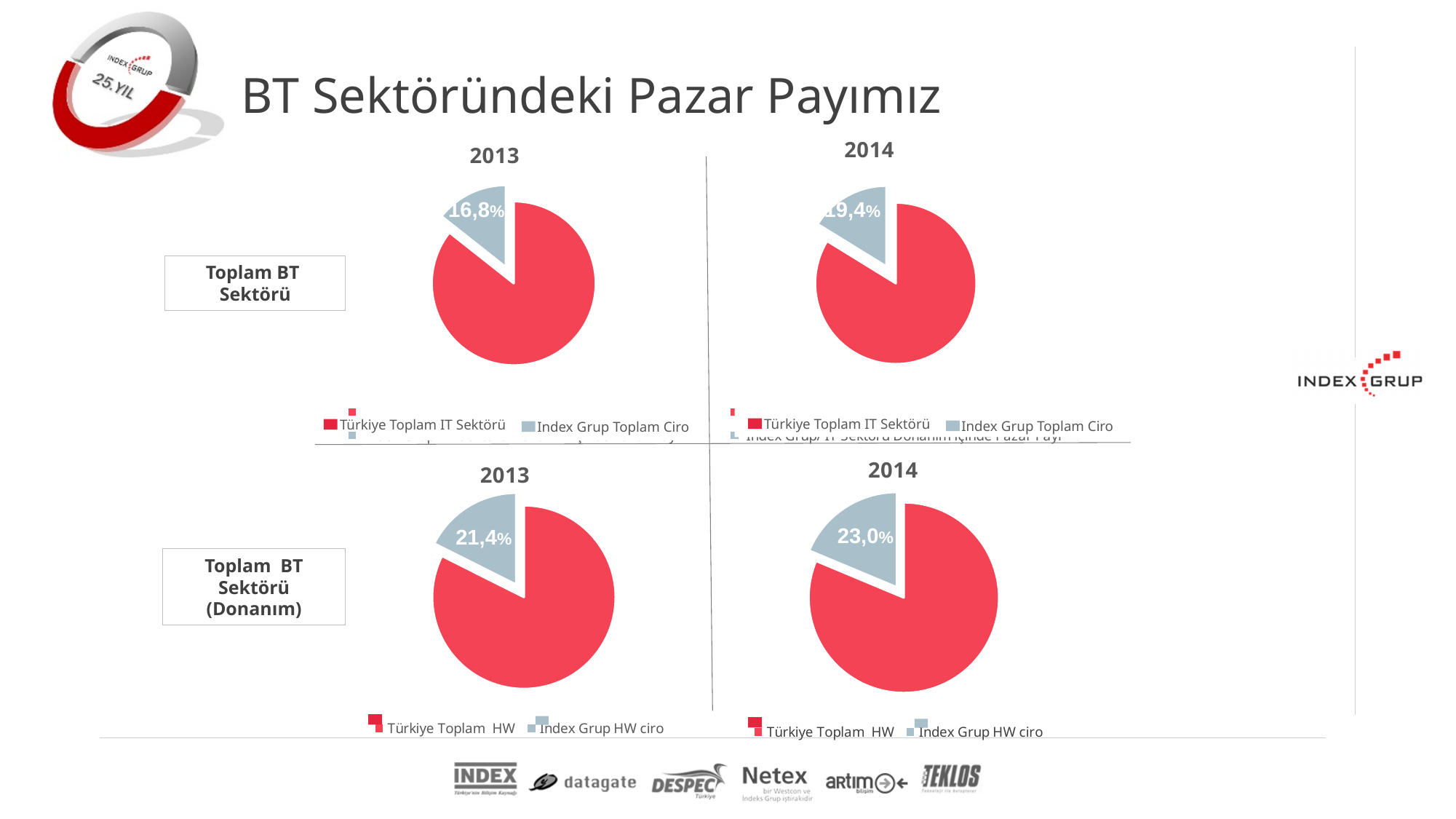
What type of chart is used on this slide? Pie chart Which is larger in the bottom-left pie chart (Donanım, 2013): the Türkiye Toplam HW slice or the Index Grup HW ciro slice? Türkiye Toplam HW In the bottom-right pie chart (Toplam BT Sektörü (Donanım), 2014), what share is labelled for the Index Grup HW ciro slice? 23,0% Comparing the Toplam BT Sektörü charts, is the Index Grup Toplam Ciro share larger in 2013 or in 2014? 2014 In the bottom-left pie chart (Toplam BT Sektörü (Donanım), 2013), what share is labelled for the Index Grup HW ciro slice? 21,4% How many entries does the legend of the bottom-right pie chart (Donanım, 2014) list? 2 In the top-right pie chart (Toplam BT Sektörü, 2014), which legend entry is shown in red? Türkiye Toplam IT Sektörü For the Toplam BT Sektörü charts, by how many percentage points did the Index Grup Toplam Ciro share change from 2013 to 2014? 2,6% In the top-left pie chart (Toplam BT Sektörü, 2013), what share is labelled for the Index Grup Toplam Ciro slice? 16,8% For the Toplam BT Sektörü (Donanım) charts, by how many percentage points did the Index Grup HW ciro share change from 2013 to 2014? 1,6% In the top-right pie chart (Toplam BT Sektörü, 2014), what share is labelled for the Index Grup Toplam Ciro slice? 19,4% How many slices does the top-left pie chart (Toplam BT Sektörü, 2013) have? 2